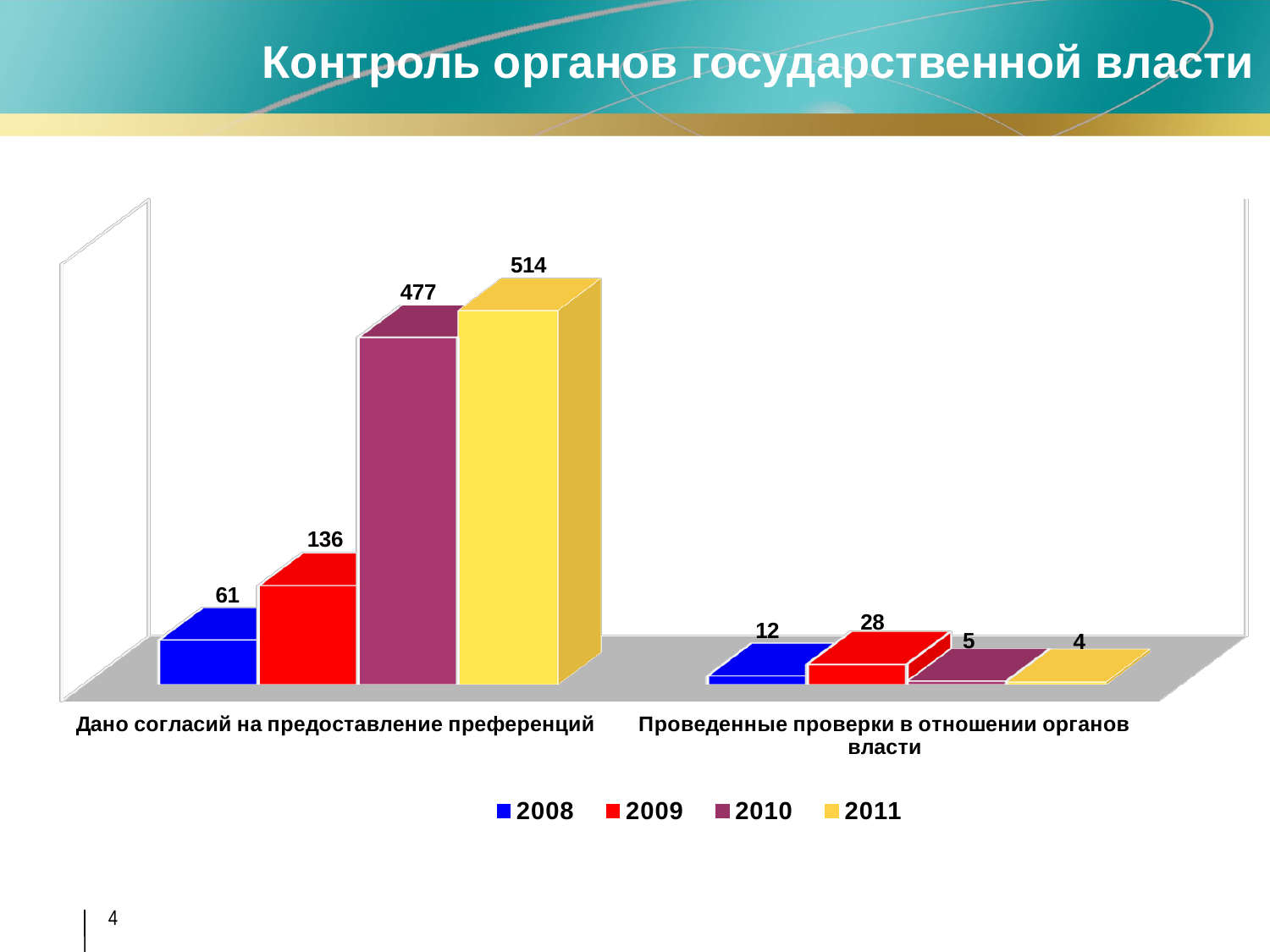
What is the value for 2011 in the category "Дано согласий на предоставление преференций"? 514 What kind of chart is shown on the slide? bar chart Which year has the lowest value in the category "Проведенные проверки в отношении органов власти"? 2011 How many categories are shown on the x axis of the chart? 2 What is the value for 2008 in the category "Дано согласий на предоставление преференций"? 61 Which is larger in the category "Проведенные проверки в отношении органов власти": the value for 2010 or the value for 2011? 2010 How many series does the legend list? 4 What is the difference between the 2009 and 2008 values in the category "Проведенные проверки в отношении органов власти"? 16 What is the difference between the 2011 and 2010 values in the category "Дано согласий на предоставление преференций"? 37 What is the value for 2009 in the category "Проведенные проверки в отношении органов власти"? 28 Which colour represents the 2010 series in the legend? purple Which year has the highest value in the category "Дано согласий на предоставление преференций"? 2011